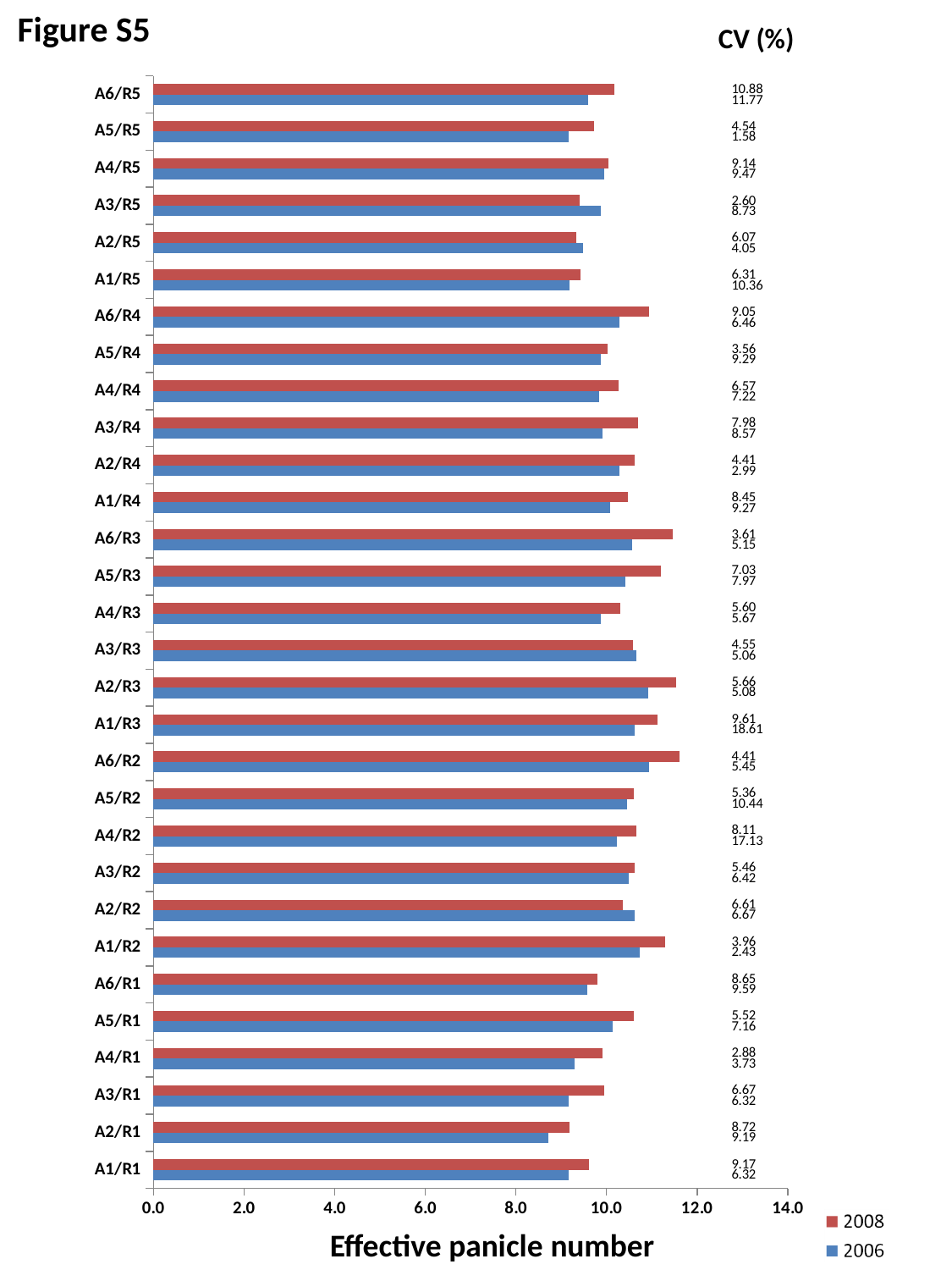
Is the 2008 value for A6/R3 greater or less than 10.0? greater What is the title of the x axis? Effective panicle number How many series does the legend list? 2 Which year does the red series represent? 2008 Is the 2006 value for A2/R1 greater or less than 10.0? less What two CV (%) values are listed next to A1/R3? 9.61 and 18.61 For A3/R5, which series has the larger value, 2008 or 2006? 2006 What kind of chart is shown on the slide? bar chart For A6/R4, which series has the larger value, 2008 or 2006? 2008 Which category has the lowest 2006 value? A2/R1 How many categories are plotted on the y axis? 30 Is the 2008 value for A6/R2 greater or less than 10.0? greater